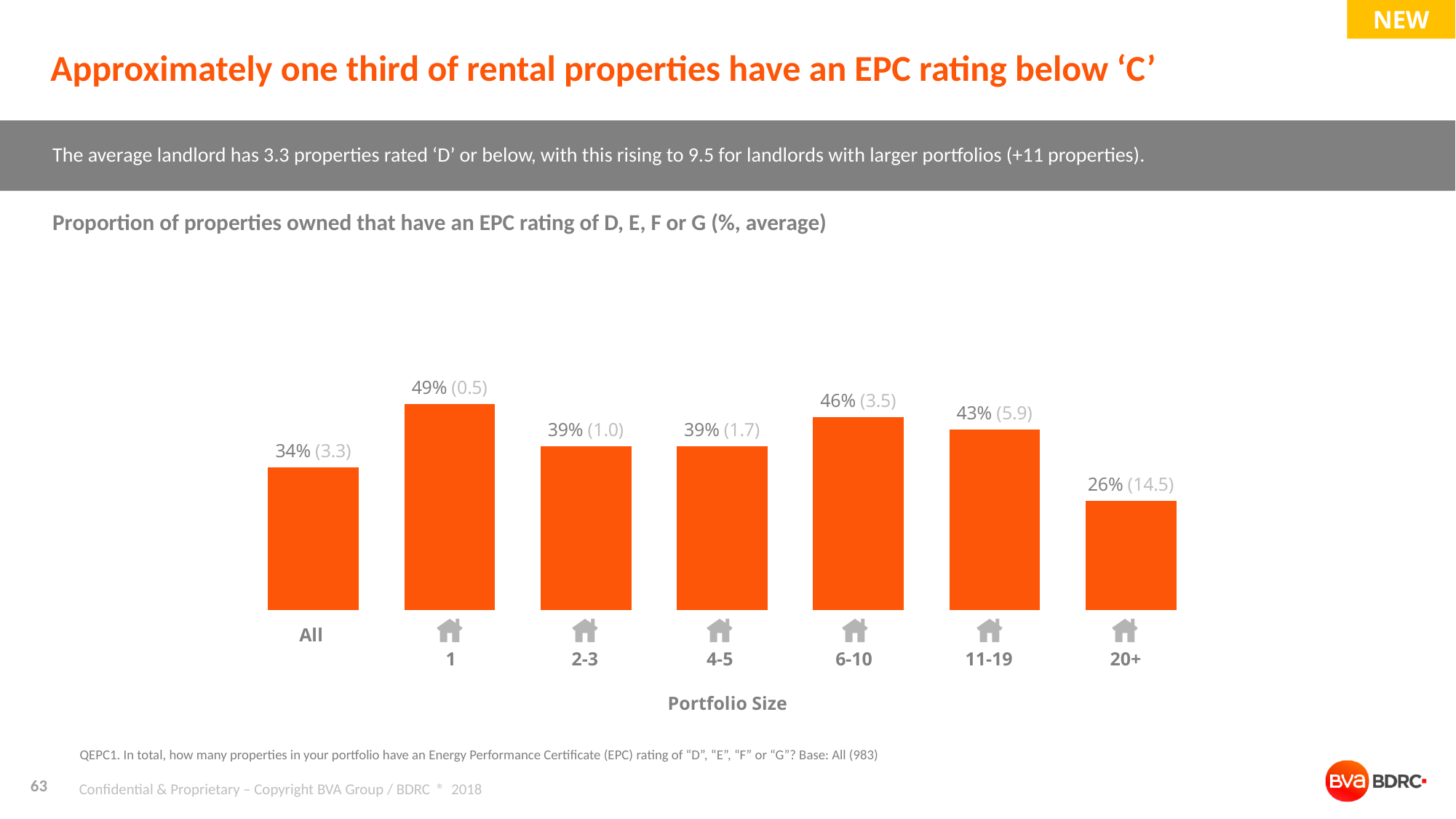
Which portfolio size has the highest percentage of properties rated D, E, F or G? 1 What is the difference in percentage between the 'All' category and the 20+ portfolio size group? 8% What is the difference in percentage between the 6-10 and 11-19 portfolio size groups? 3% How many bars are shown in the chart? 7 What is the x-axis label of the chart? Portfolio Size What percentage is shown for the 'All' category? 34% What is the average number of properties rated D or below for the 20+ portfolio size group? 14.5 What percentage of properties have an EPC rating of D, E, F or G for landlords with a portfolio size of 1? 49% Which has a higher percentage: the 2-3 portfolio size group or the 6-10 portfolio size group? 6-10 What type of chart is shown on the slide? Bar chart Which portfolio size has the lowest percentage of properties rated D, E, F or G? 20+ What is the average number of properties rated D or below shown for the 11-19 portfolio size group? 5.9